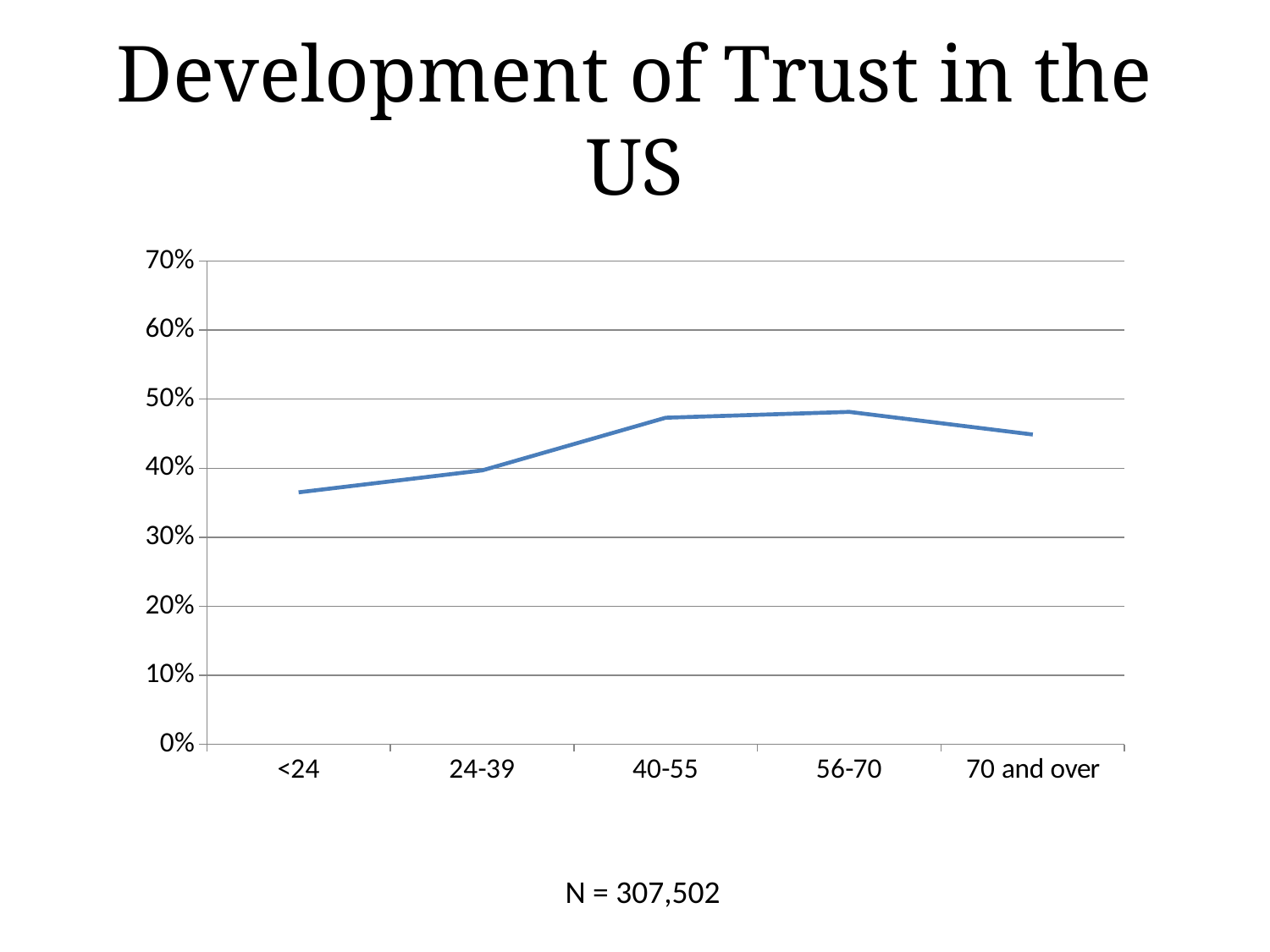
What is the title of the slide? Development of Trust in the US Which age category has the lowest value? <24 Which is larger, the value for 70 and over or the value for 24-39? 70 and over Is the value for 40-55 greater or less than 40%? greater Which is larger, the value for 40-55 or the value for <24? 40-55 Is the value for 56-70 greater or less than 50%? less Does the line rise or fall between <24 and 40-55? rise How many age categories are shown on the x axis? 5 Is the value for 24-39 greater or less than 30%? greater What kind of chart is shown on the slide? line chart